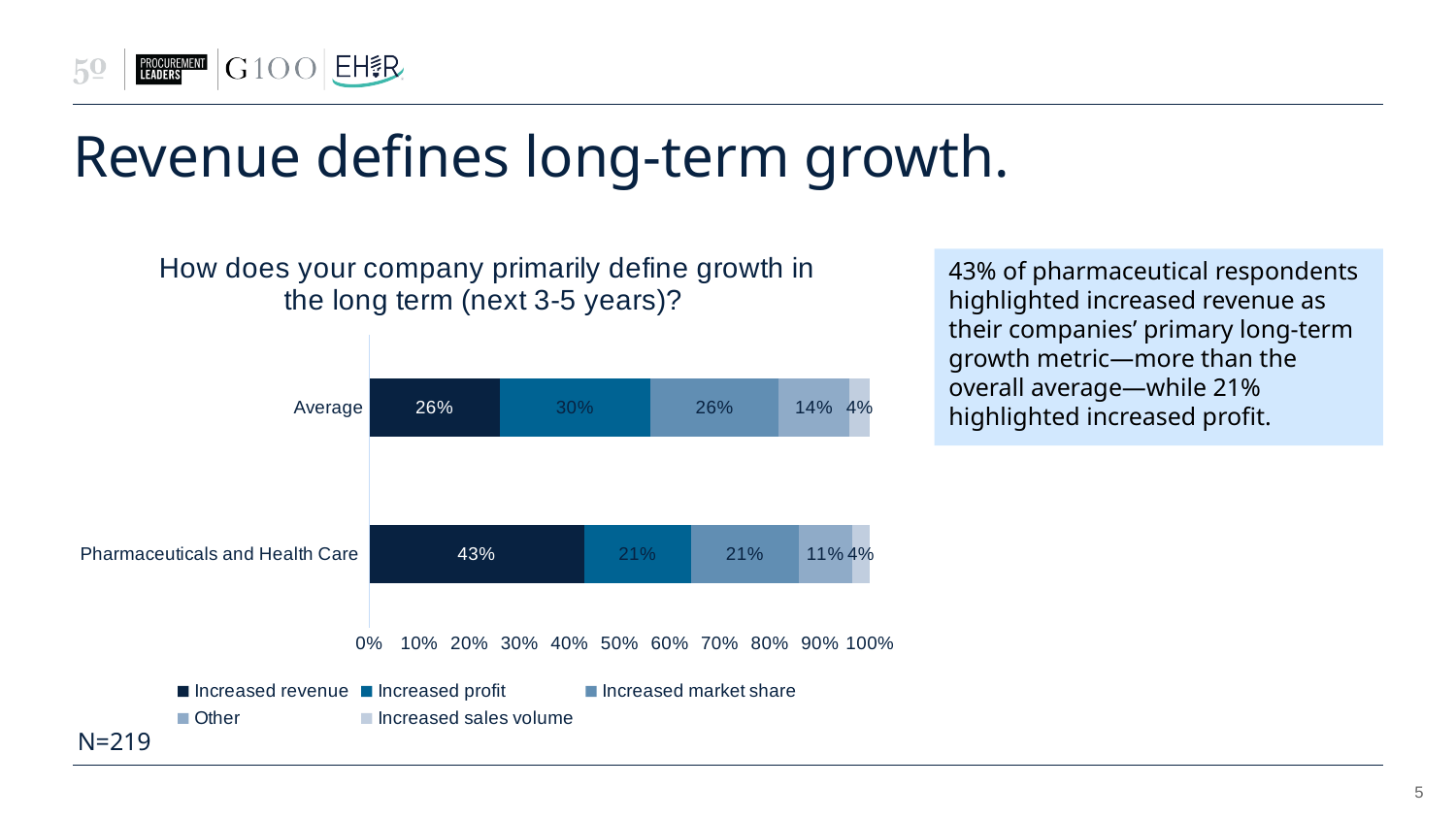
Which category has the higher value for Increased revenue, Average or Pharmaceuticals and Health Care? Pharmaceuticals and Health Care Which series has the largest share in the Average bar? Increased profit How many series does the legend list? 5 What percentage of Pharmaceuticals and Health Care respondents selected Increased revenue? 43% What is the Increased market share value for Pharmaceuticals and Health Care? 21% What is the title of the chart? How does your company primarily define growth in the long term (next 3-5 years)? What is the Increased sales volume value for Pharmaceuticals and Health Care? 4% What kind of chart is shown on the slide? Stacked bar chart What is the difference between the Increased revenue value for Pharmaceuticals and Health Care and the Average Increased revenue value? 17% How many categories (bars) are plotted in the chart? 2 What is the Average value for Increased profit? 30% What is the Average value for Other? 14%